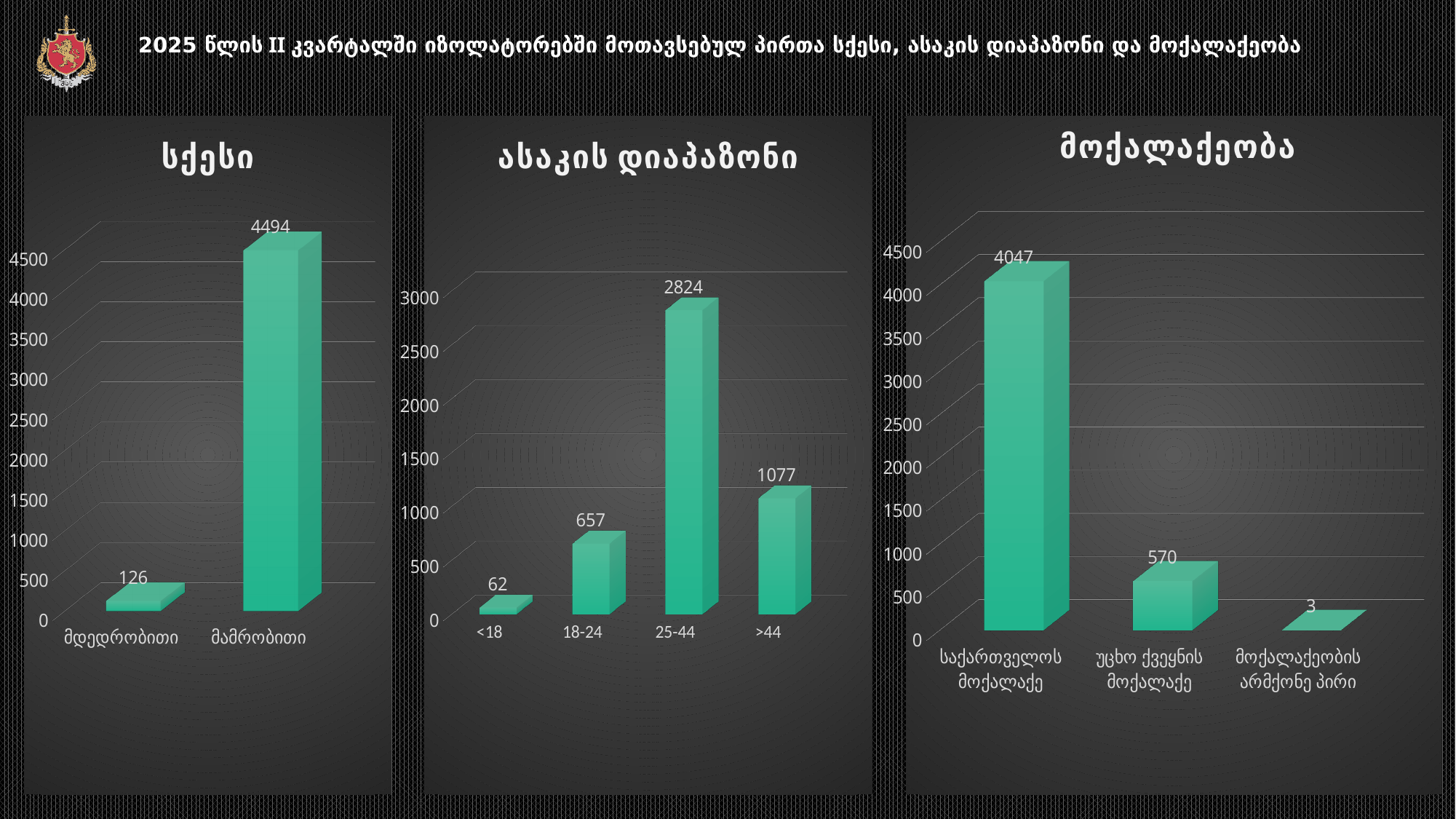
In the left chart titled "სქესი", what is the value for "მდედრობითი"? 126 In the middle chart titled "ასაკის დიაპაზონი", how many categories are shown on the x axis? 4 In the middle chart titled "ასაკის დიაპაზონი", which is larger, the value for "18-24" or the value for ">44"? >44 In the right chart titled "მოქალაქეობა", what is the value for "უცხო ქვეყნის მოქალაქე"? 570 In the left chart titled "სქესი", what is the value for "მამრობითი"? 4494 In the middle chart titled "ასაკის დიაპაზონი", what is the difference between the values for "25-44" and ">44"? 1747 In the middle chart titled "ასაკის დიაპაზონი", which category has the lowest value? <18 What kind of chart is the right chart titled "მოქალაქეობა"? bar chart In the right chart titled "მოქალაქეობა", which category has the highest value? საქართველოს მოქალაქე In the right chart titled "მოქალაქეობა", what is the value for "მოქალაქეობის არმქონე პირი"? 3 In the middle chart titled "ასაკის დიაპაზონი", what is the value for the "25-44" category? 2824 In the left chart titled "სქესი", what is the difference between the values for "მამრობითი" and "მდედრობითი"? 4368